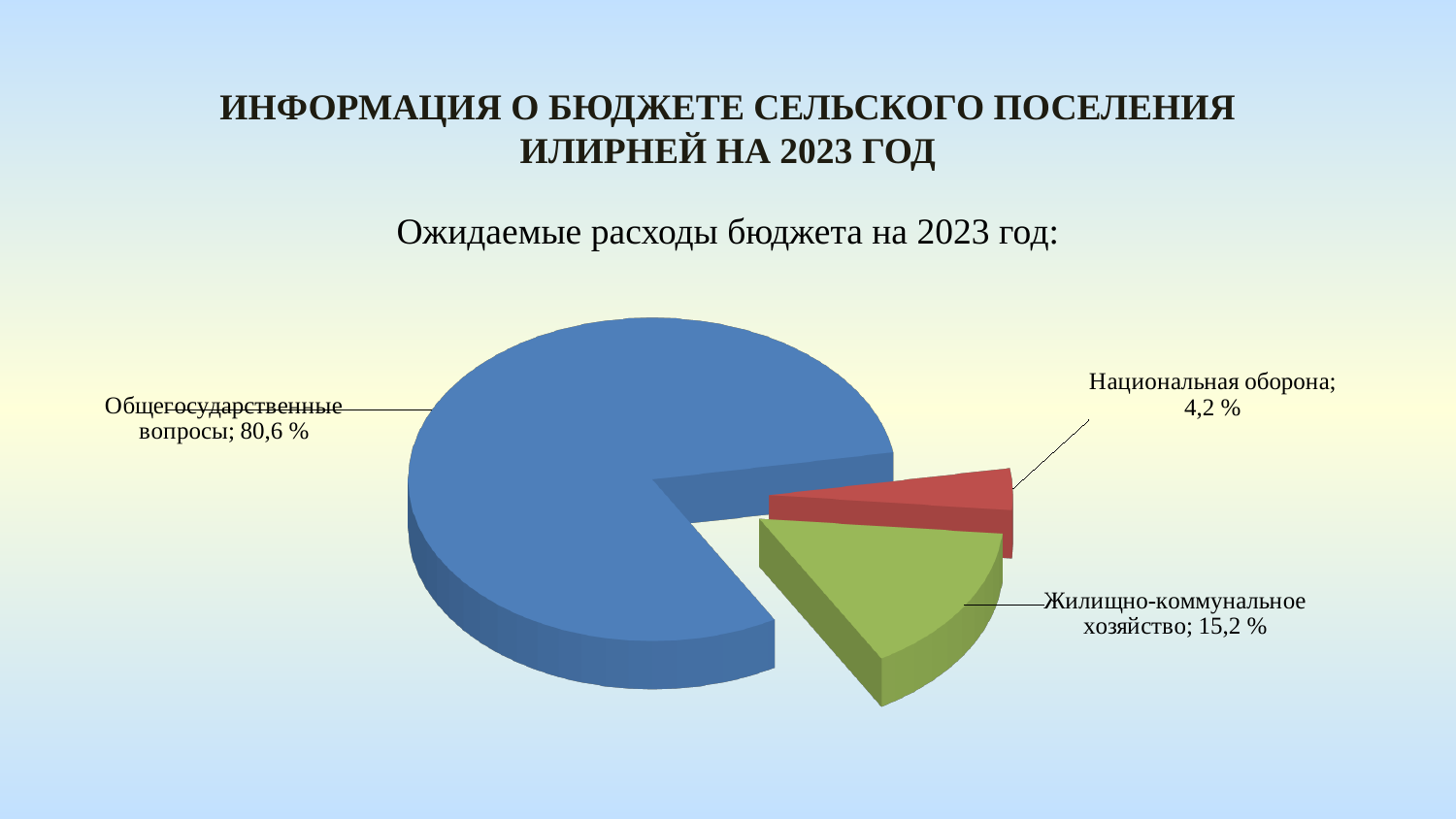
What is the difference in percentage points between Жилищно-коммунальное хозяйство and Национальная оборона? 11 What share of the pie does Жилищно-коммунальное хозяйство have? 15,2 % What share of the pie does Общегосударственные вопросы have? 80,6 % What is the difference in percentage points between Общегосударственные вопросы and Жилищно-коммунальное хозяйство? 65,4 What share of the pie does Национальная оборона have? 4,2 % What is the subtitle above the chart? Ожидаемые расходы бюджета на 2023 год: What colour is the slice for Жилищно-коммунальное хозяйство? Green Which is larger: the slice for Жилищно-коммунальное хозяйство or the slice for Национальная оборона? Жилищно-коммунальное хозяйство Which category has the largest slice of the pie? Общегосударственные вопросы What kind of chart is shown on the slide? Pie chart Which category has the smallest slice of the pie? Национальная оборона How many categories are shown in the pie chart? 3